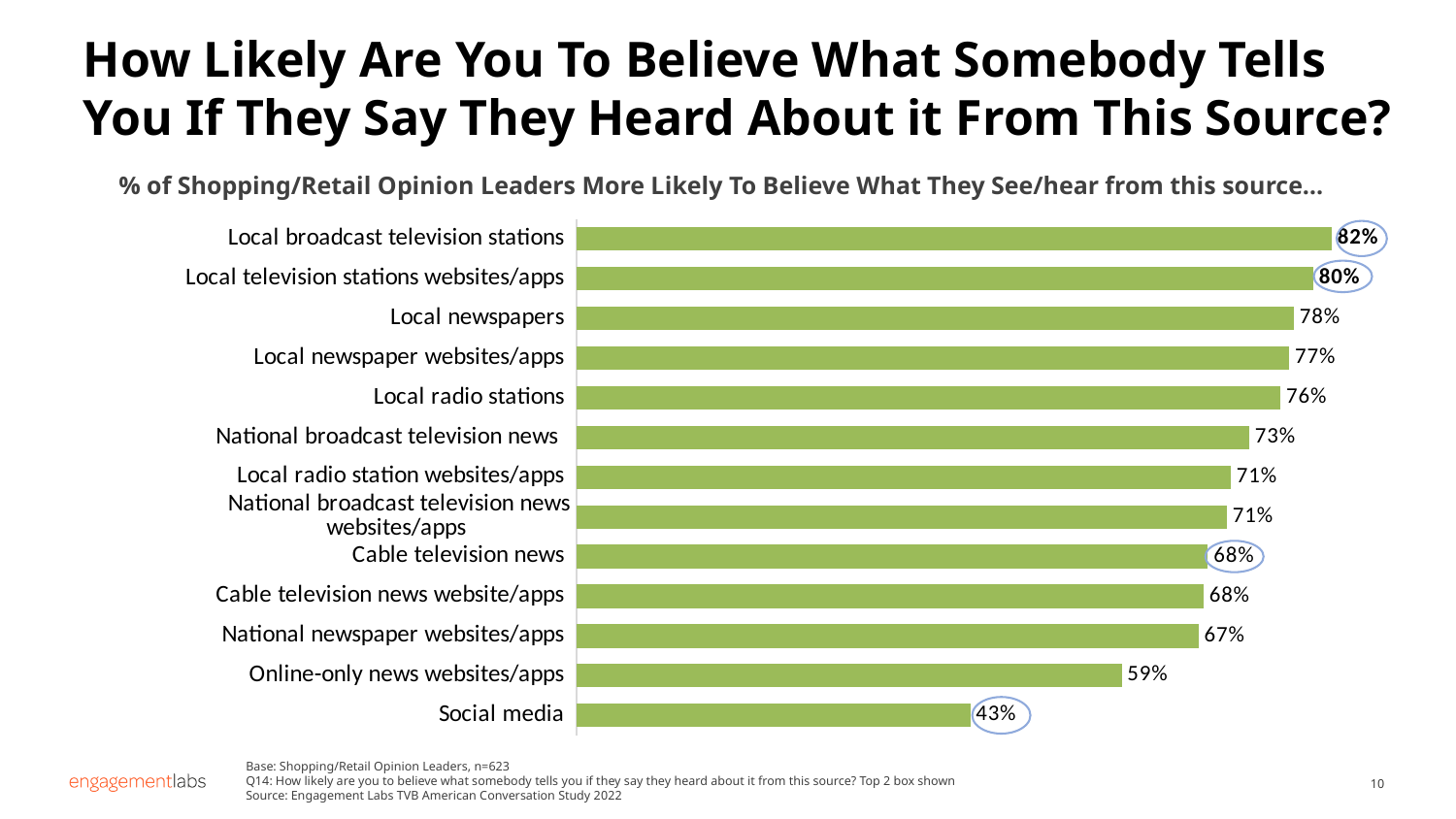
How many sources (categories) are shown on the chart? 13 What is the value shown for local radio stations? 76% Which has a higher value: national broadcast television news or national newspaper websites/apps? National broadcast television news What is the value shown for online-only news websites/apps? 59% What is the difference in percentage points between local newspapers and cable television news? 10 What is the value shown for social media? 43% What kind of chart is shown on the slide? Bar chart What is the base sample size (n) stated in the footnote of the slide? 623 Which source has the lowest percentage on the chart? Social media Which source has the highest percentage on the chart? Local broadcast television stations What is the difference in percentage points between local broadcast television stations and social media? 39 What percentage of Shopping/Retail Opinion Leaders are more likely to believe what they hear from local broadcast television stations? 82%